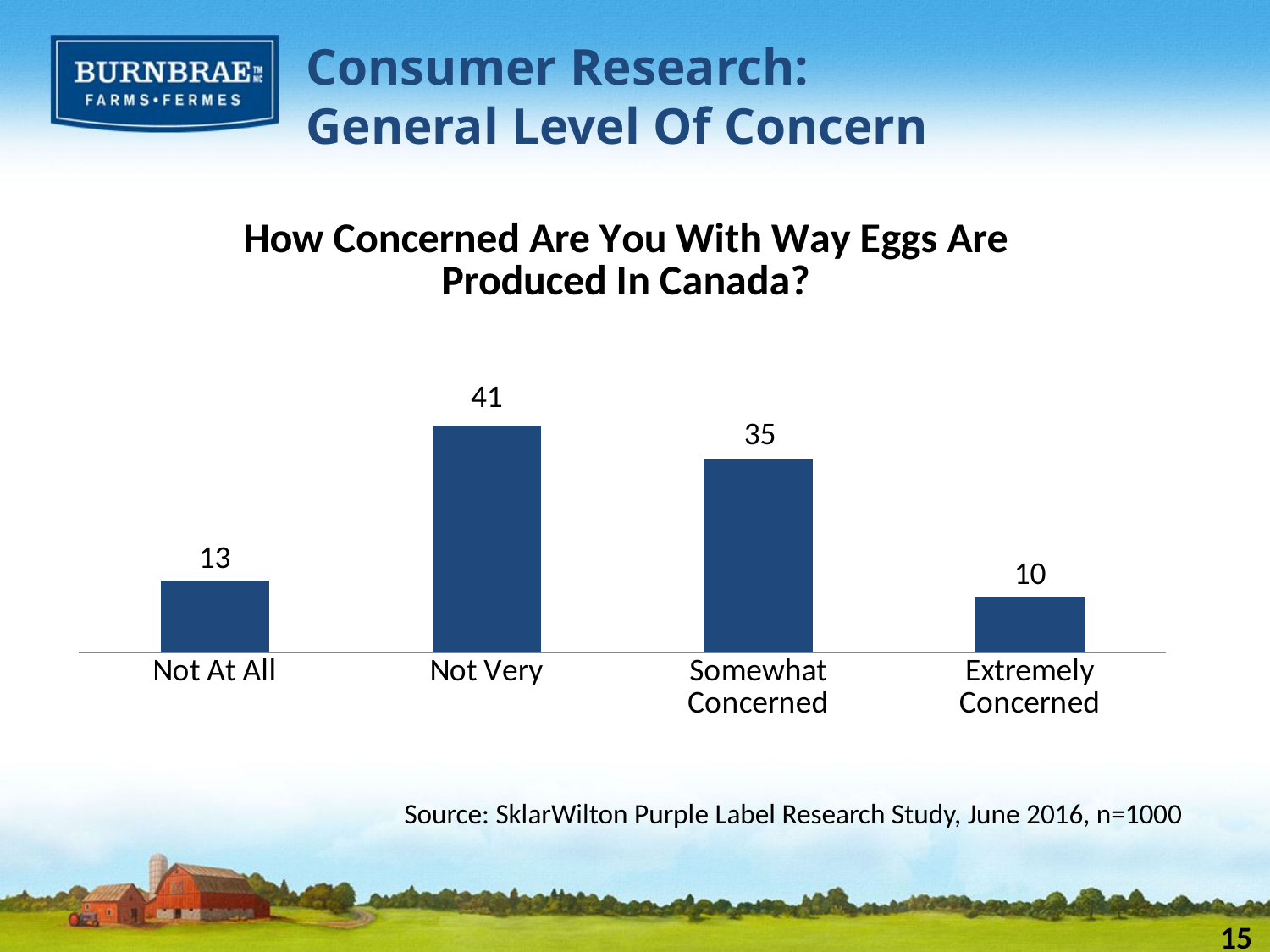
What is the difference between the values for Not Very and Somewhat Concerned? 6 What is the title of the chart? How Concerned Are You With Way Eggs Are Produced In Canada? What is the value for Not Very? 41 Which is larger, the value for Not At All or the value for Extremely Concerned? Not At All What is the value for Somewhat Concerned? 35 Which category has the lowest value? Extremely Concerned What is the value for Extremely Concerned? 10 What is the value for Not At All? 13 What is the difference between the values for Not At All and Extremely Concerned? 3 How many categories are shown in the chart? 4 What kind of chart is shown on the slide? Bar chart Which category has the highest value? Not Very